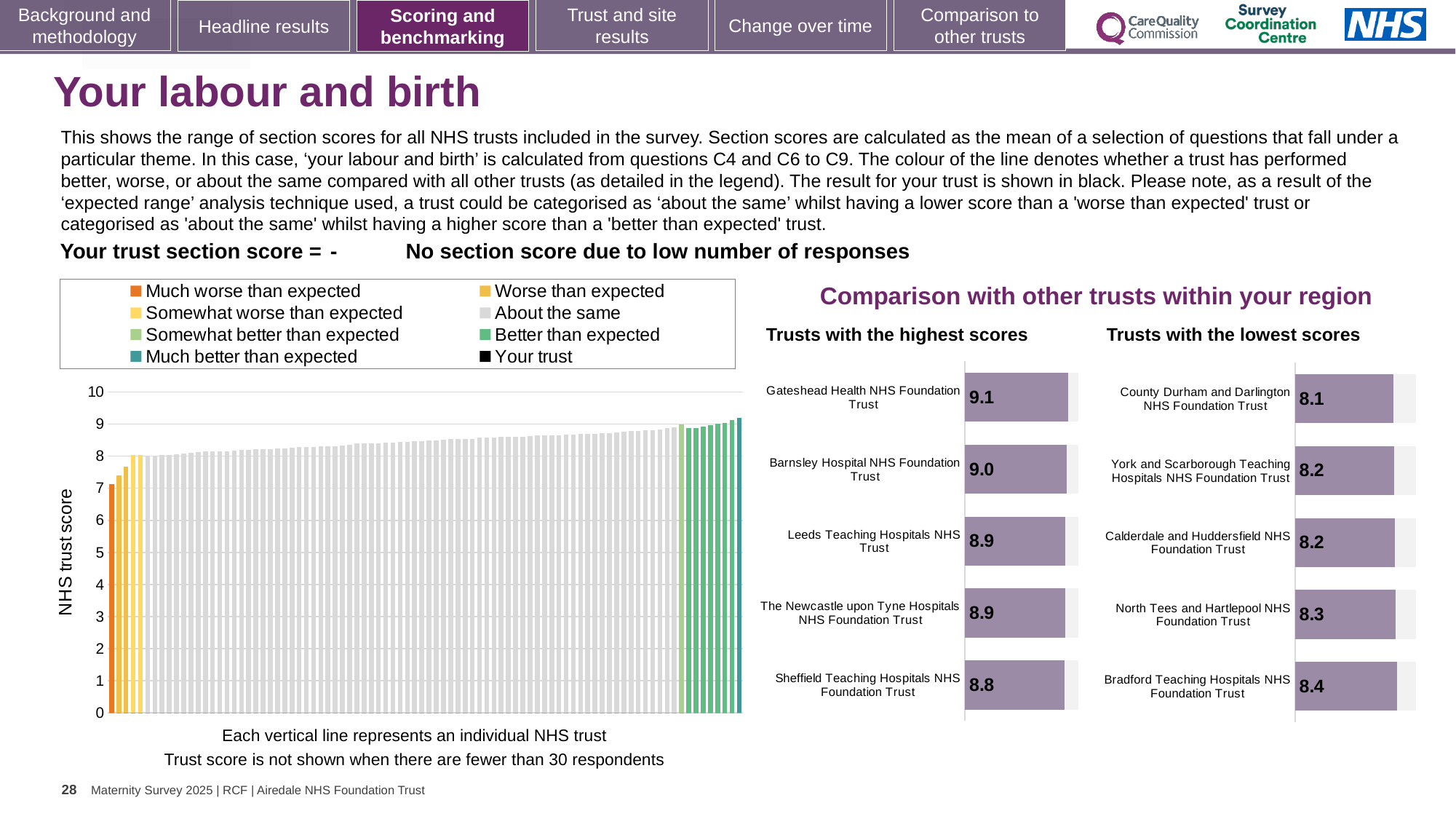
In the 'Trusts with the lowest scores' chart, what is the score for County Durham and Darlington NHS Foundation Trust? 8.1 In the 'Trusts with the highest scores' chart, what is the score for Barnsley Hospital NHS Foundation Trust? 9.0 In the 'Trusts with the lowest scores' chart, which trust has the highest score? Bradford Teaching Hospitals NHS Foundation Trust What kind of chart is the large chart on the left with the 'NHS trust score' axis? bar chart In the 'Trusts with the highest scores' chart, what is the score for Gateshead Health NHS Foundation Trust? 9.1 In the left-hand 'NHS trust score' chart, do the bar values rise or fall from left to right? rise How many entries does the legend of the left-hand 'NHS trust score' chart list? 8 In the 'Trusts with the lowest scores' chart, how many trusts are shown? 5 In the 'Trusts with the highest scores' chart, which trust has the highest score? Gateshead Health NHS Foundation Trust In the 'Trusts with the lowest scores' chart, which has the larger score: North Tees and Hartlepool NHS Foundation Trust or York and Scarborough Teaching Hospitals NHS Foundation Trust? North Tees and Hartlepool NHS Foundation Trust In the 'Trusts with the lowest scores' chart, what is the difference between the scores of Bradford Teaching Hospitals NHS Foundation Trust and County Durham and Darlington NHS Foundation Trust? 0.3 In the 'Trusts with the highest scores' chart, which trust has the lowest score? Sheffield Teaching Hospitals NHS Foundation Trust